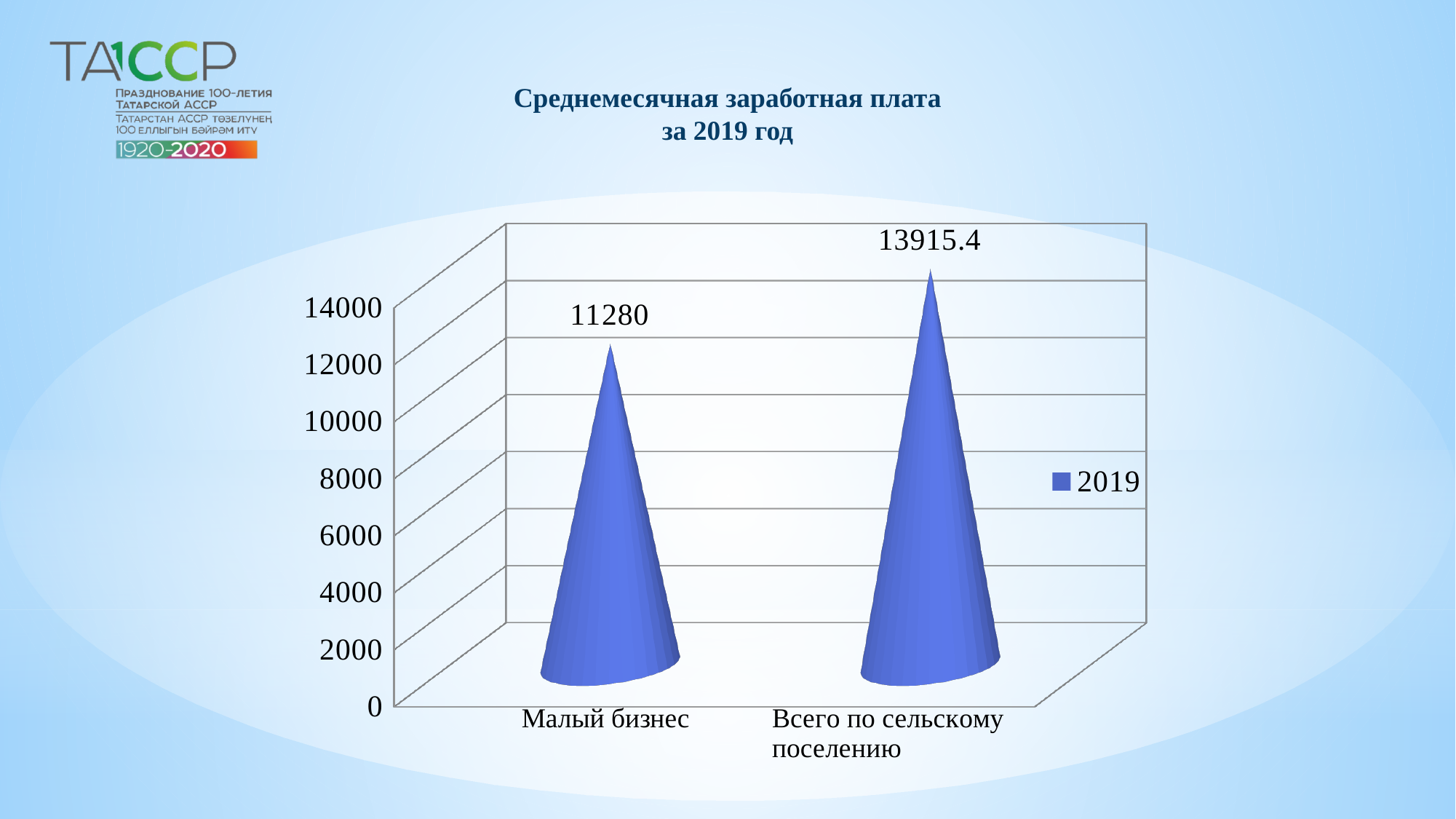
How many categories are shown on the x axis? 2 Is the value for Всего по сельскому поселению greater or less than 12000? greater Which category has the highest value? Всего по сельскому поселению What is the value for Всего по сельскому поселению? 13915.4 How many series does the legend list? 1 What is the difference between the values for Всего по сельскому поселению and Малый бизнес? 2635.4 Which category has the lowest value? Малый бизнес Is the value for Малый бизнес greater or less than 12000? less Which is larger, the value for Малый бизнес or the value for Всего по сельскому поселению? Всего по сельскому поселению What kind of chart is shown on the slide? bar chart What is the title of the chart? Среднемесячная заработная плата за 2019 год What is the value for Малый бизнес? 11280